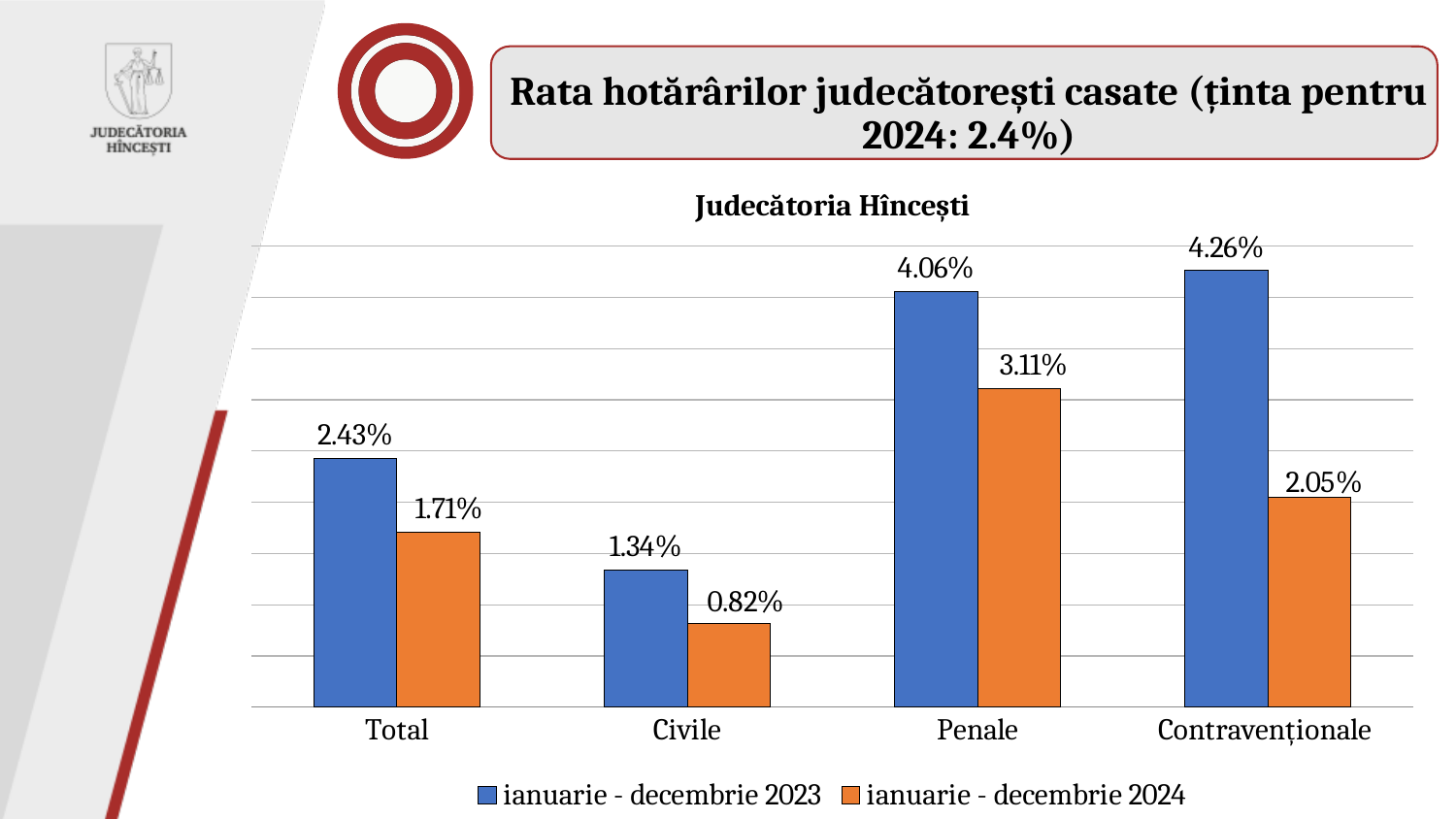
Which category has the lowest value in the ianuarie - decembrie 2024 series? Civile What is the value for Civile in the ianuarie - decembrie 2024 series? 0.82% Which colour represents the ianuarie - decembrie 2024 series? Orange What is the value for Total in the ianuarie - decembrie 2024 series? 1.71% How many series does the legend list? 2 Which category has the highest value in the ianuarie - decembrie 2023 series? Contravenționale Which is larger: the 2024 value for Penale or the 2023 value for Total? The 2024 value for Penale (3.11%) What is the difference between the 2023 and 2024 values for Contravenționale? 2.21% How many categories are shown on the x axis? 4 What is the value for Penale in the ianuarie - decembrie 2023 series? 4.06% What is the title of the chart? Judecătoria Hîncești What kind of chart is shown on the slide? Bar chart